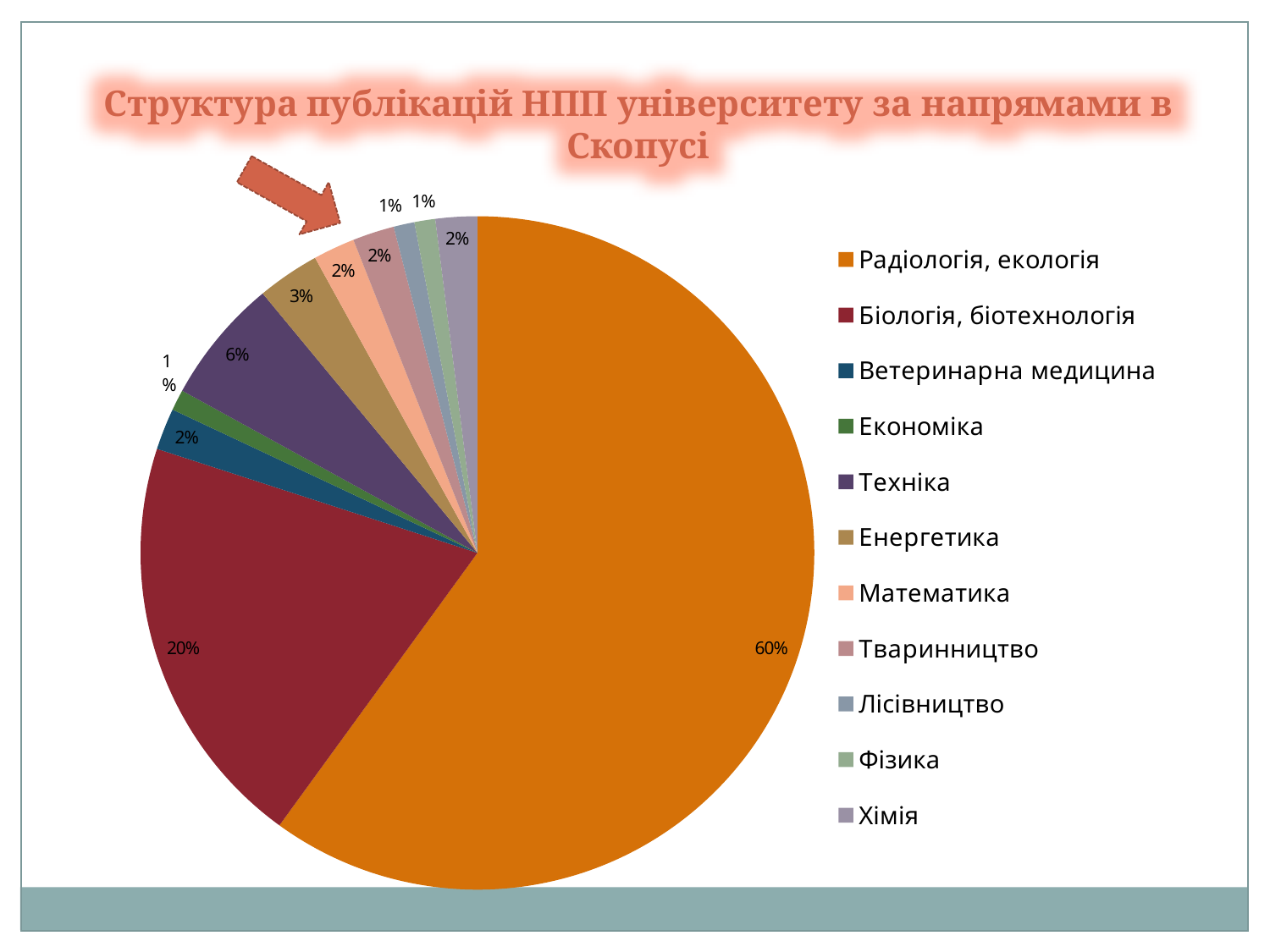
Which category has the largest share of the pie? Радіологія, екологія What share of publications does Радіологія, екологія account for? 60% Which is larger, the share for Техніка or the share for Енергетика? Техніка What is the value shown for Енергетика? 3% What is the title of the chart on the slide? Структура публікацій НПП університету за напрямами в Скопусі What is the combined share of Радіологія, екологія and Біологія, біотехнологія? 80% How many categories does the legend list? 11 What is the difference between the shares of Радіологія, екологія and Біологія, біотехнологія? 40% What colour is the slice for Радіологія, екологія? orange What share of publications does Біологія, біотехнологія account for? 20% What is the value shown for Техніка? 6% What type of chart is shown on the slide? pie chart